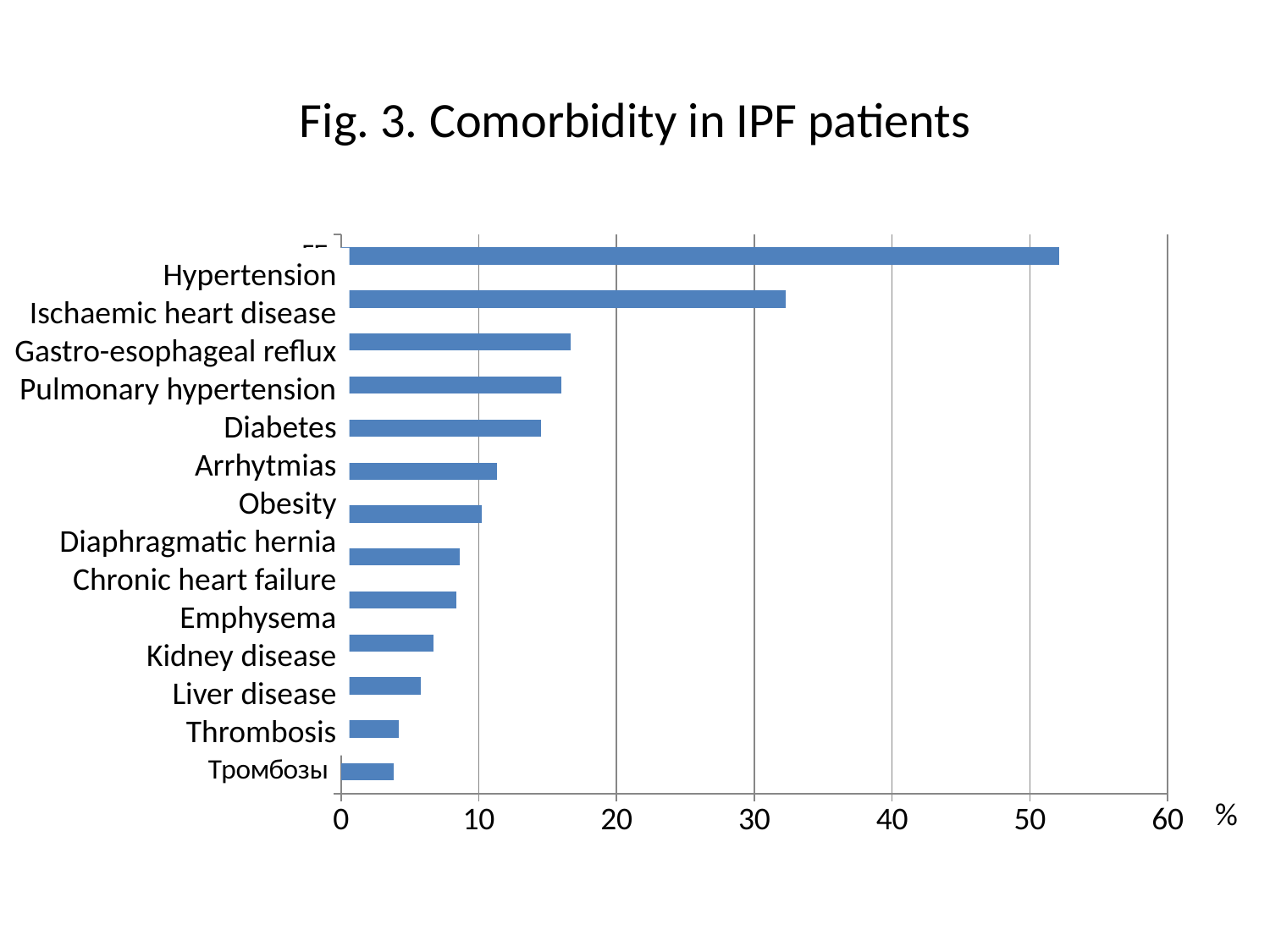
Which comorbidity has the lowest value? Thrombosis What unit is shown at the end of the horizontal axis? % Is the value for Diabetes greater or less than 10? greater Is the value for Hypertension greater or less than 50? greater Is the value for Emphysema greater or less than 10? less Which is larger, the value for Hypertension or the value for Ischaemic heart disease? Hypertension What is the title of the chart? Fig. 3. Comorbidity in IPF patients Which is larger, the value for Diabetes or the value for Kidney disease? Diabetes What kind of chart is shown on the slide? bar chart Which comorbidity has the highest value? Hypertension